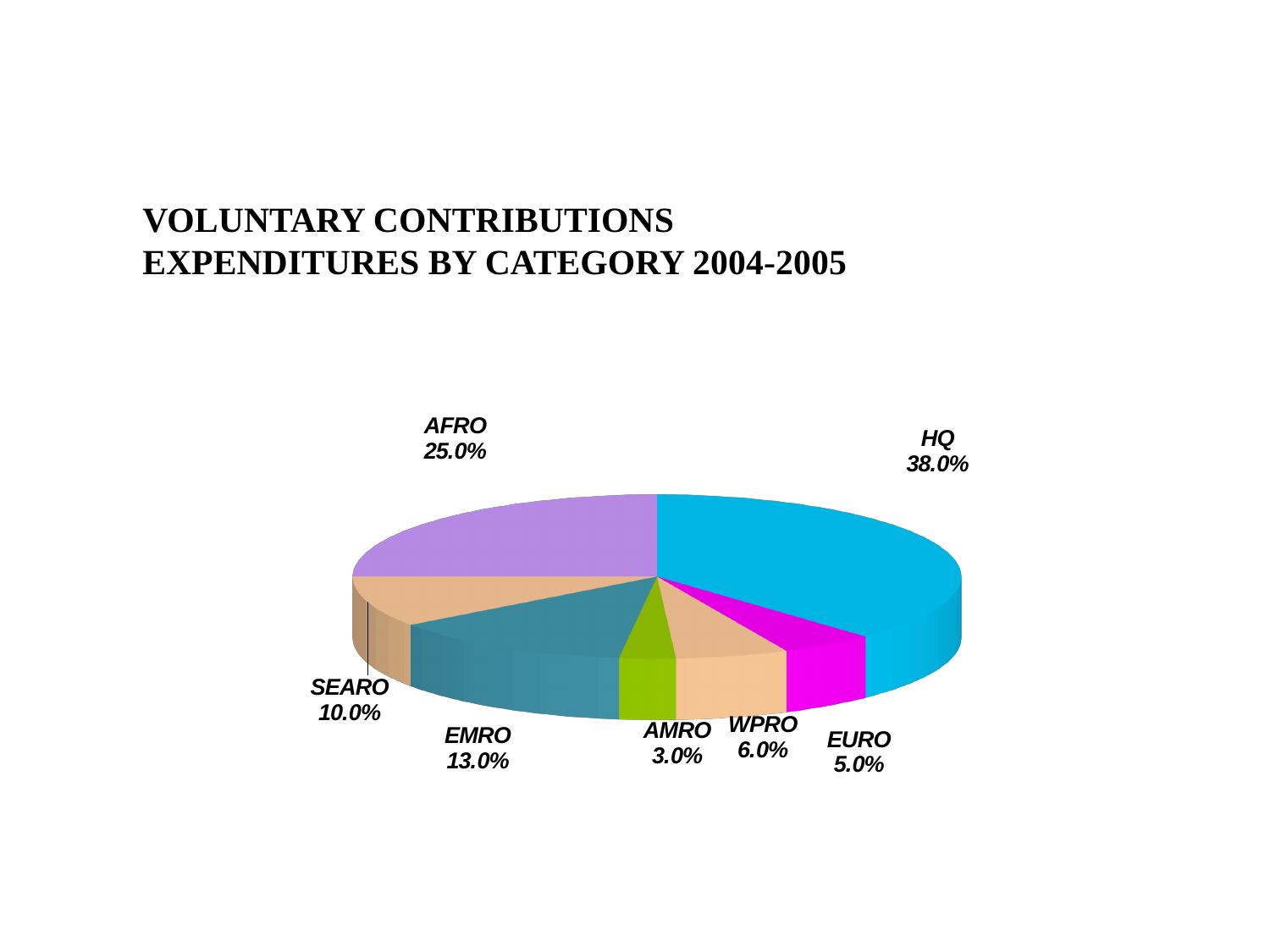
Which category has the smallest share of the pie? AMRO What is the value for EMRO? 13.0% What percentage is shown for AFRO? 25.0% What share of voluntary contributions expenditures does HQ account for? 38.0% How many categories are shown in the pie chart? 7 What is the difference in percentage points between HQ and AFRO? 13.0% What kind of chart is shown on the slide? Pie chart Which is larger, the share for WPRO or the share for EURO? WPRO Which category has the largest share of the pie? HQ What is the combined share of EMRO and SEARO? 23.0% What is the title of the chart on the slide? VOLUNTARY CONTRIBUTIONS EXPENDITURES BY CATEGORY 2004-2005 What percentage is shown for SEARO? 10.0%